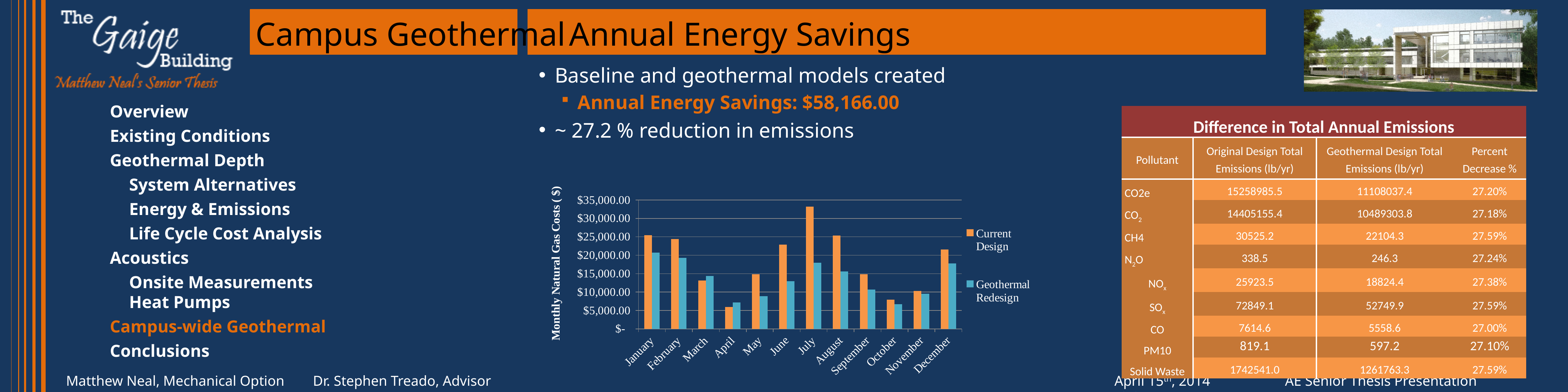
How many months are shown along the x axis of the chart? 12 Which month has the highest Geothermal Redesign monthly natural gas cost? January Which month has the lowest Current Design monthly natural gas cost? April Is the Geothermal Redesign value for April greater or less than $10,000.00? less In June, which series has the larger monthly natural gas cost, Current Design or Geothermal Redesign? Current Design Is the Current Design value for July greater or less than $30,000.00? greater How many series does the chart's legend list? 2 Which month has the highest Current Design monthly natural gas cost? July What is the label on the chart's vertical axis? Monthly Natural Gas Costs ($) What kind of chart is shown on the slide? bar chart Which series is shown in orange in the chart? Current Design